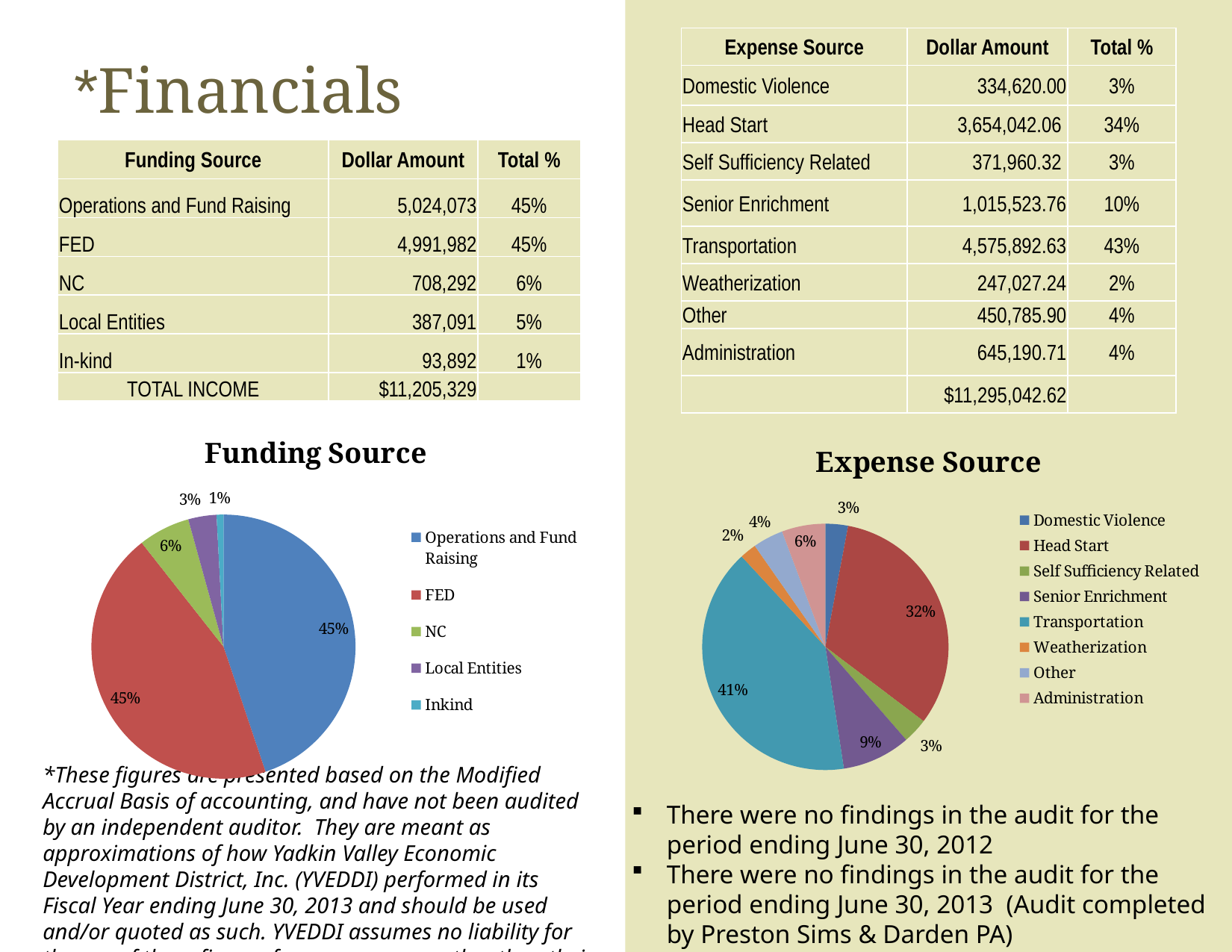
How many entries does the legend of the Expense Source chart list? 8 What kind of chart is the Funding Source chart? pie chart How many entries does the legend of the Funding Source chart list? 5 In the Funding Source chart, which slice is larger, NC or Local Entities? NC In the Funding Source chart, what share of the pie is NC? 6% In the Expense Source chart, what share of the pie is Senior Enrichment? 9% In the Expense Source chart, which category has the largest slice? Transportation In the Expense Source chart, which category has the smallest slice? Weatherization In the Funding Source chart, what share of the pie is Inkind? 1% In the Expense Source chart, how many percentage points larger is the Transportation slice than the Head Start slice? 9 In the Funding Source chart, which category has the smallest slice? Inkind